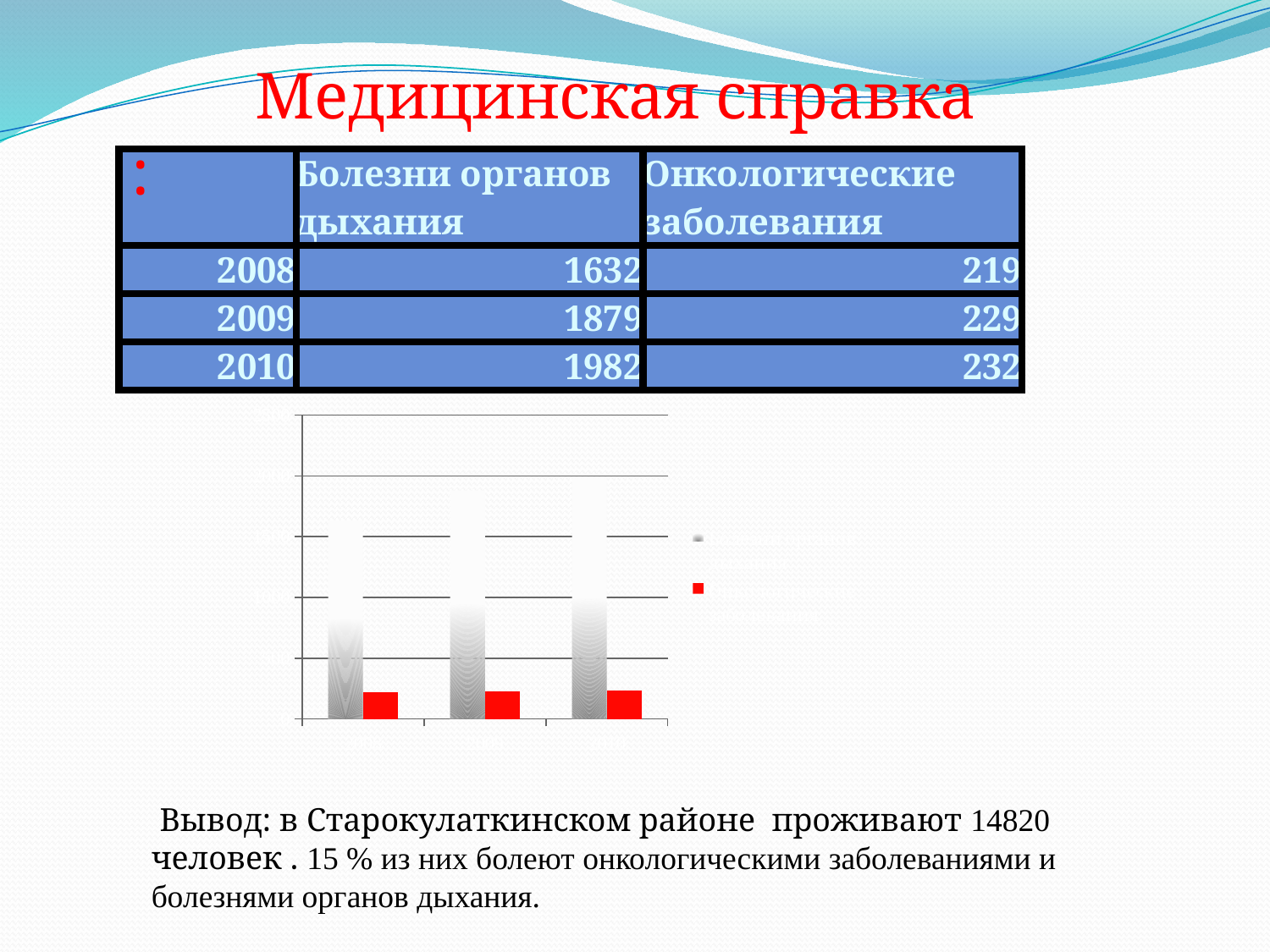
In the table above the chart, which year has the highest value for Онкологические заболевания? 2010 What colour are the shorter bars in each group of the chart? red In the leftmost group of bars, which bar is taller, the grey one or the red one? the grey one Which group of bars has the tallest grey bar: the leftmost, middle or rightmost? rightmost Do the grey bars rise or fall from left to right across the chart? rise In the table above the chart, what is the value for Болезни органов дыхания in 2010? 1982 In the table above the chart, what is the value for Онкологические заболевания in 2008? 219 How many groups of bars does the chart show? 3 How many data series (bar colours) are plotted in the chart? 2 What kind of chart is shown on the slide? bar chart In the table above the chart, what is the difference between the Болезни органов дыхания values for 2010 and 2008? 350 Which group of bars has the shortest grey bar: the leftmost, middle or rightmost? leftmost